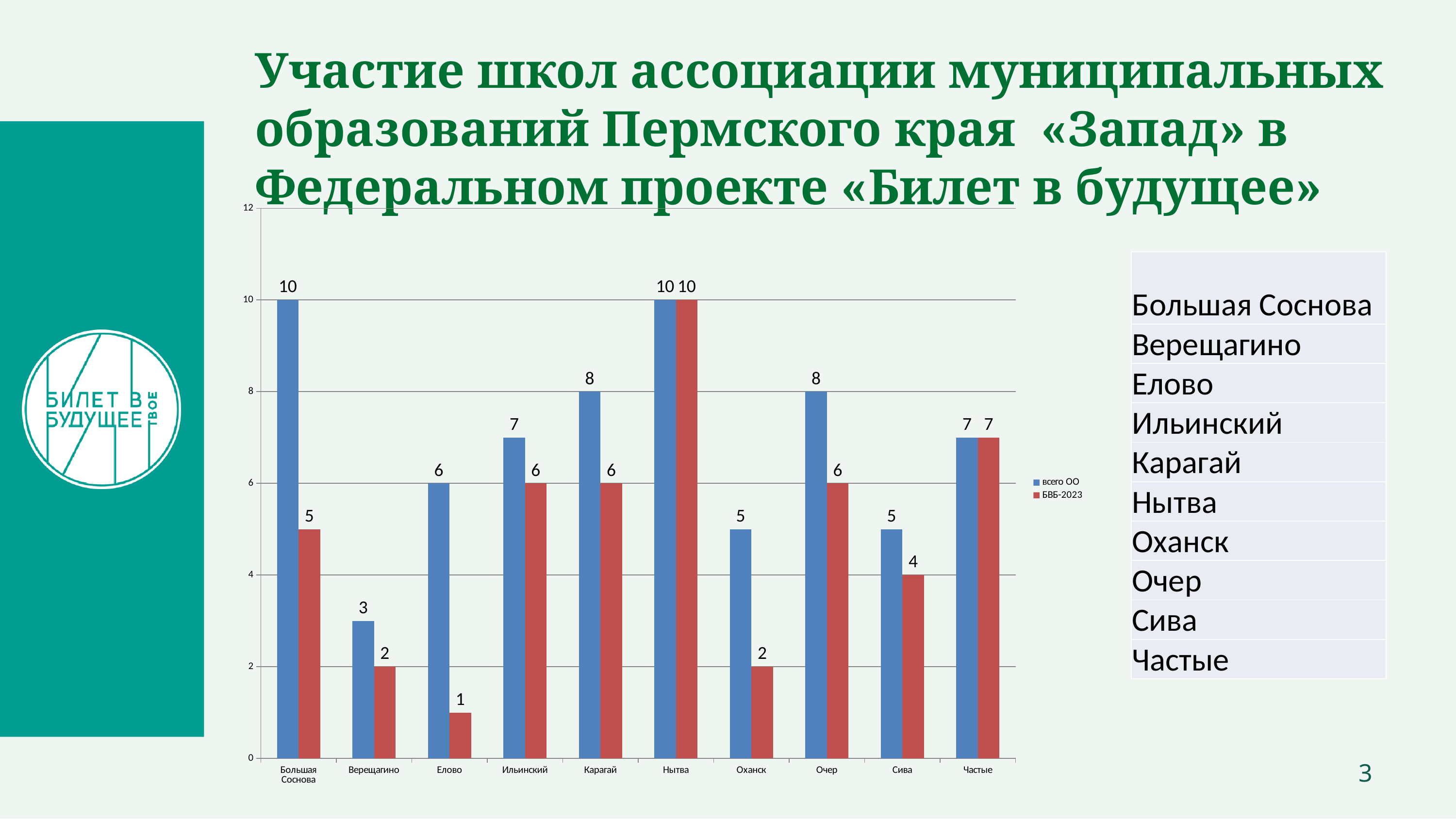
Which category has the lowest 'всего ОО' value? Верещагино What kind of chart is shown on the slide? bar chart Which colour represents the 'БВБ-2023' series? red Which category has the lowest 'БВБ-2023' value? Елово How many categories are shown on the x axis? 10 What is the difference between 'всего ОО' and 'БВБ-2023' for Большая Соснова? 5 What is the difference between 'всего ОО' and 'БВБ-2023' for Оханск? 3 What is the value of 'БВБ-2023' for Елово? 1 What is the value of 'БВБ-2023' for Сива? 4 Which is larger: 'всего ОО' for Карагай or 'всего ОО' for Ильинский? Карагай What is the value of 'всего ОО' for Большая Соснова? 10 How many series does the legend list? 2